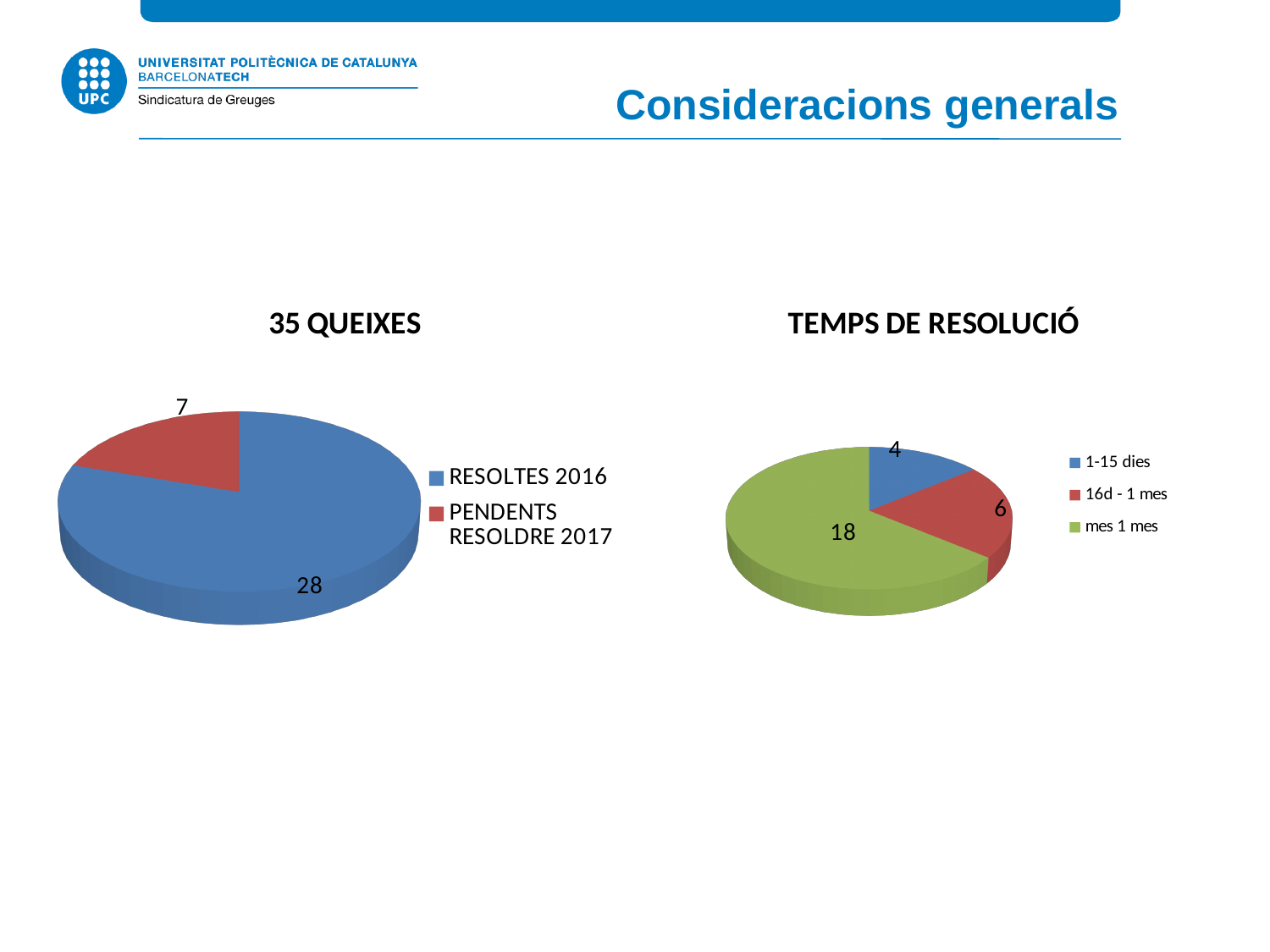
In the '35 QUEIXES' chart, what is the value for PENDENTS RESOLDRE 2017? 7 In the 'TEMPS DE RESOLUCIÓ' chart, what is the value for '1-15 dies'? 4 In the '35 QUEIXES' chart, what is the value for RESOLTES 2016? 28 In the '35 QUEIXES' chart, what share of the pie does RESOLTES 2016 represent? 80% What kind of chart is the '35 QUEIXES' chart? Pie chart In the '35 QUEIXES' chart, what is the difference between RESOLTES 2016 and PENDENTS RESOLDRE 2017? 21 In the 'TEMPS DE RESOLUCIÓ' chart, which category has the largest slice? mes 1 mes In the 'TEMPS DE RESOLUCIÓ' chart, how many categories are shown? 3 In the 'TEMPS DE RESOLUCIÓ' chart, which category has the smallest slice? 1-15 dies How many entries does the legend of the '35 QUEIXES' chart list? 2 In the 'TEMPS DE RESOLUCIÓ' chart, what is the difference between 'mes 1 mes' and '16d - 1 mes'? 12 In the 'TEMPS DE RESOLUCIÓ' chart, what is the value for 'mes 1 mes'? 18